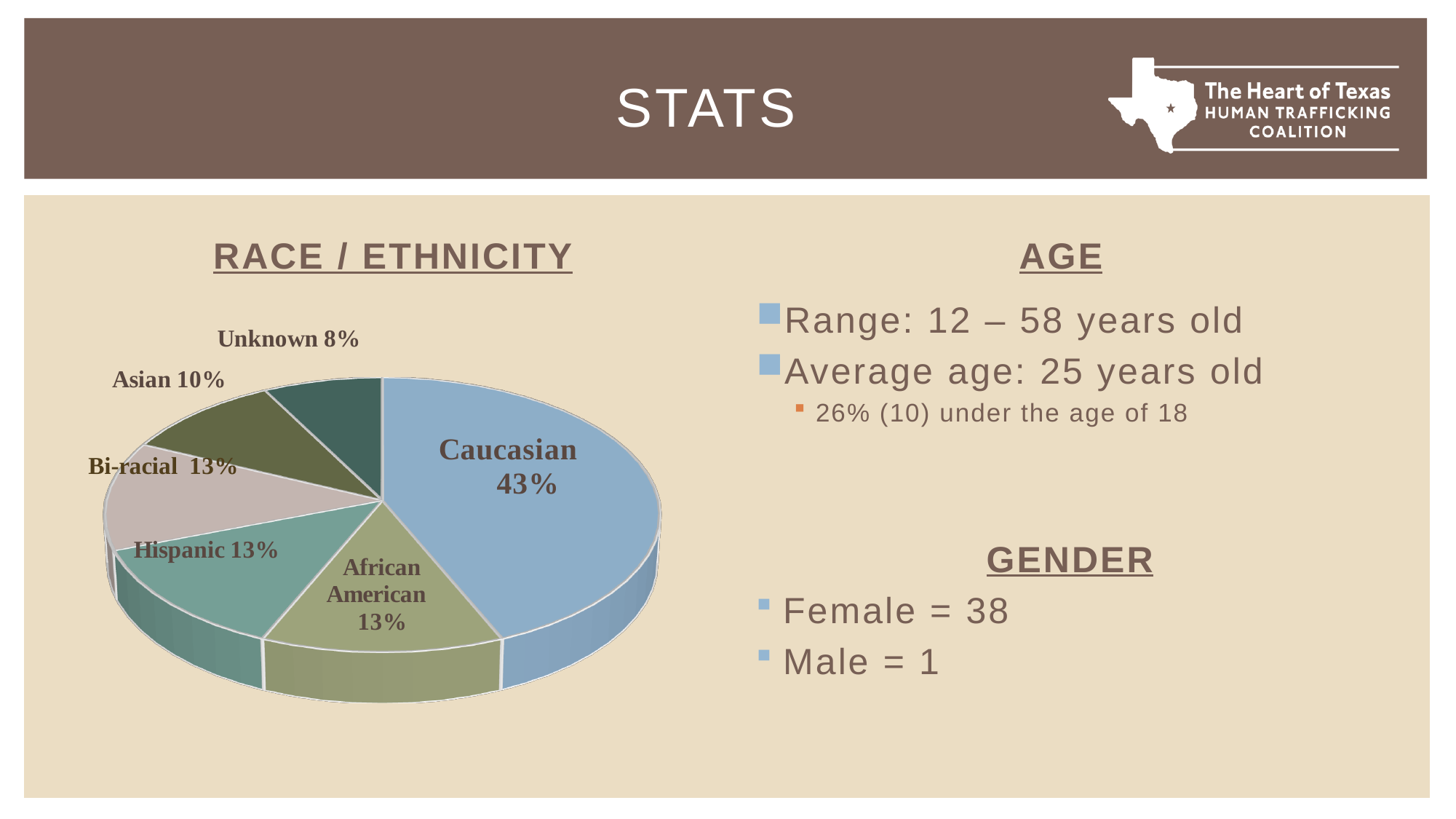
What percentage does the Asian slice represent in the Race / Ethnicity pie chart? 10% What colour is the Caucasian slice in the Race / Ethnicity pie chart? Light blue In the Race / Ethnicity pie chart, which is larger: the Asian slice or the Unknown slice? Asian How many slices does the Race / Ethnicity pie chart have? 6 What is the difference in percentage points between the Caucasian and African American slices in the Race / Ethnicity pie chart? 30 Which category has the smallest slice in the Race / Ethnicity pie chart? Unknown What percentage is labelled for the Unknown slice in the Race / Ethnicity pie chart? 8% What percentage does the Hispanic slice show in the Race / Ethnicity pie chart? 13% What is the title of the chart on the slide? RACE / ETHNICITY What type of chart is used to show Race / Ethnicity? Pie chart What share of the Race / Ethnicity pie chart is Caucasian? 43% Which category has the largest slice in the Race / Ethnicity pie chart? Caucasian